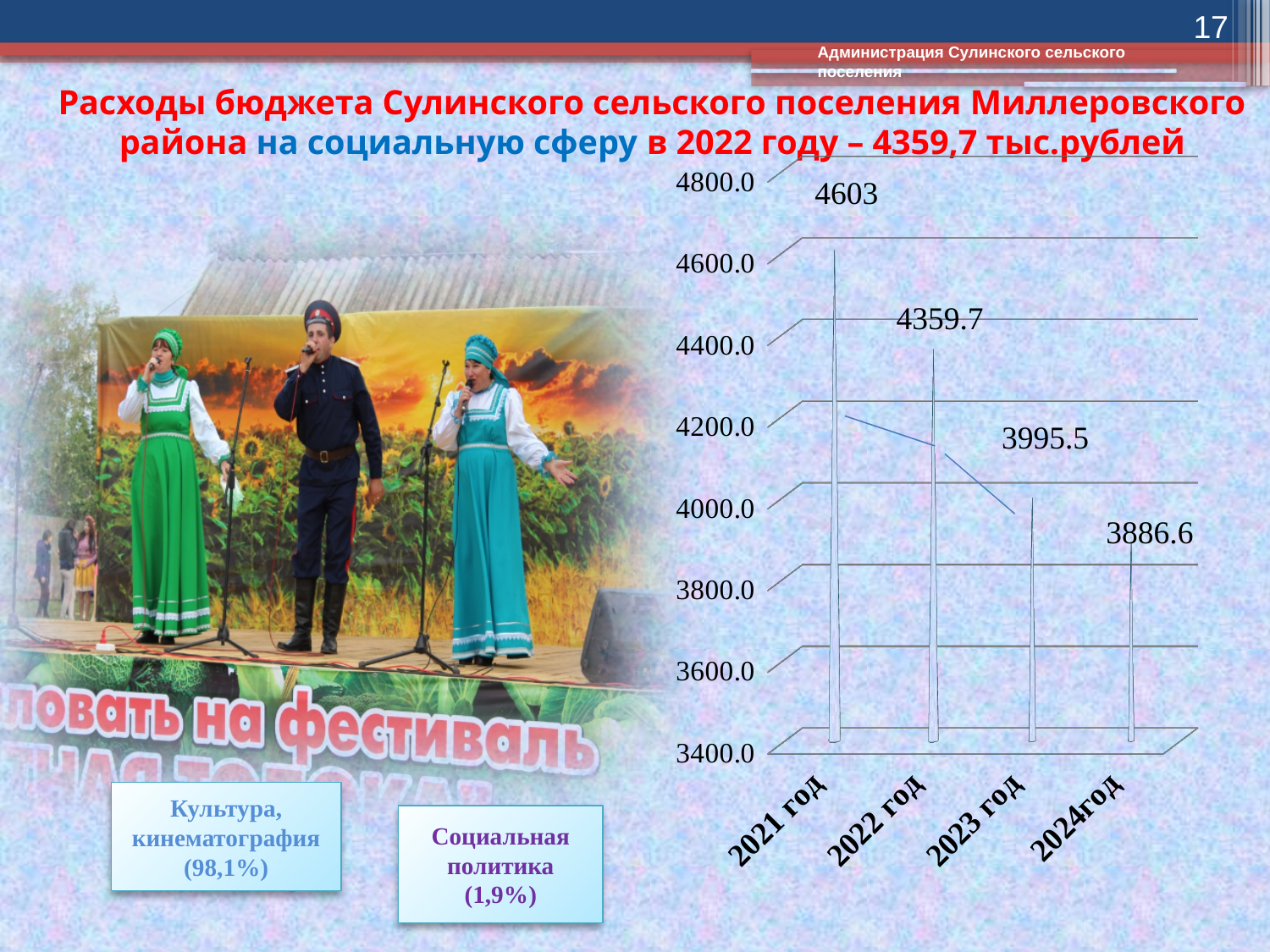
How many years are shown on the x axis of the chart? 4 Which is larger, the value for 2022 год or the value for 2023 год? 2022 год What is the value for 2023 год? 3995.5 What is the value for 2021 год? 4603 What kind of chart is shown on the slide? bar chart What is the difference between the values for 2023 год and 2024год? 108.9 Do the values rise or fall from 2021 год to 2024год? fall Which year has the highest value? 2021 год Which year has the lowest value? 2024год What is the difference between the values for 2021 год and 2022 год? 243.3 What is the value for 2022 год? 4359.7 What is the value for 2024год? 3886.6